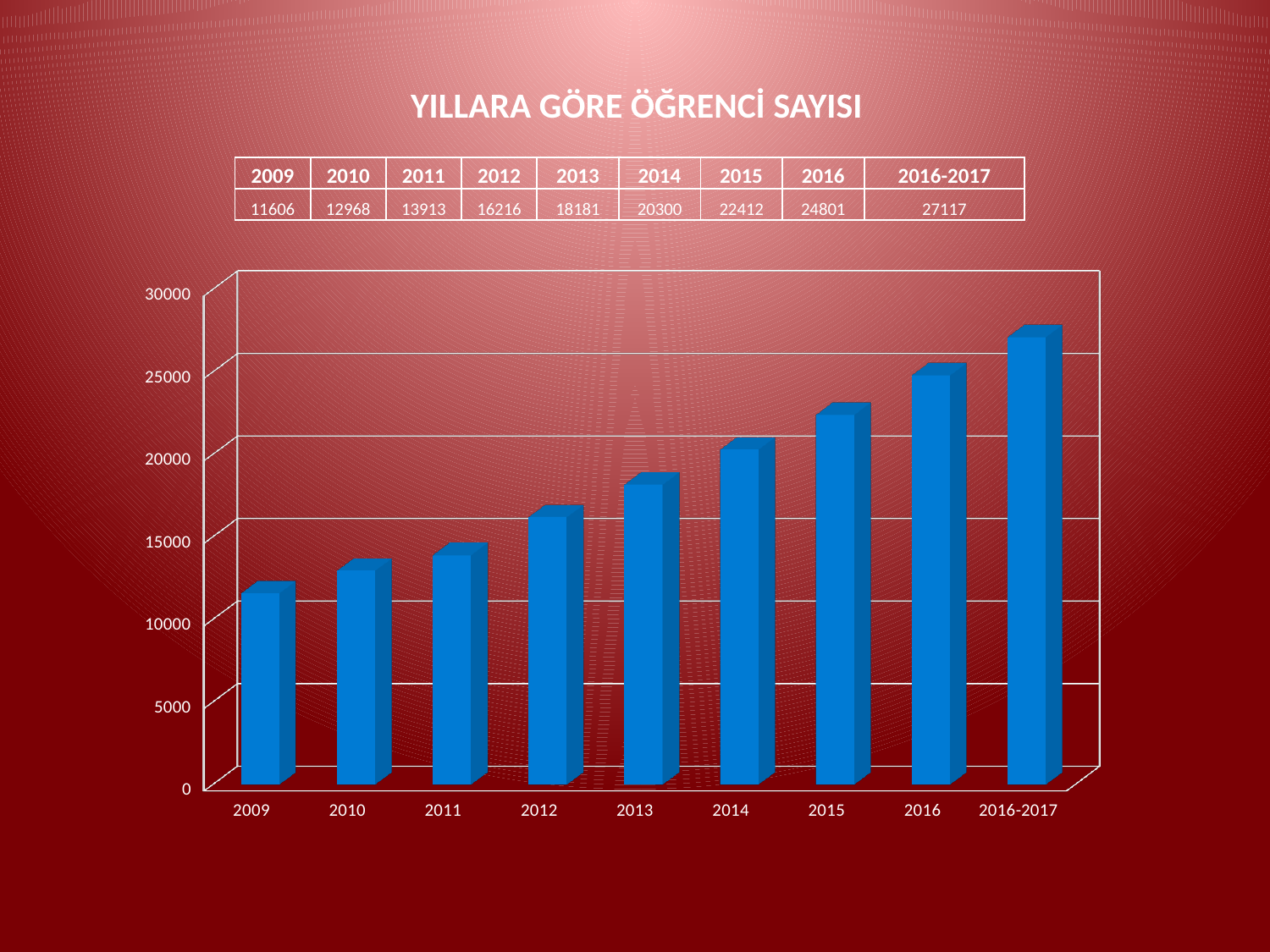
Is the value for 2014 greater or less than 20000? greater How many years (categories) are shown on the x axis of the chart? 9 Which is larger, the number of students in 2012 or in 2011? 2012 What is the number of students for 2016-2017? 27117 Which year has the highest number of students? 2016-2017 What kind of chart is shown on the slide? bar chart What is the difference between the number of students in 2016-2017 and in 2009? 15511 What is the number of students for 2013? 18181 Do the values rise or fall from 2009 to 2016-2017? rise What is the number of students for 2009? 11606 What is the difference between the number of students in 2016 and in 2015? 2389 Which year has the lowest number of students? 2009